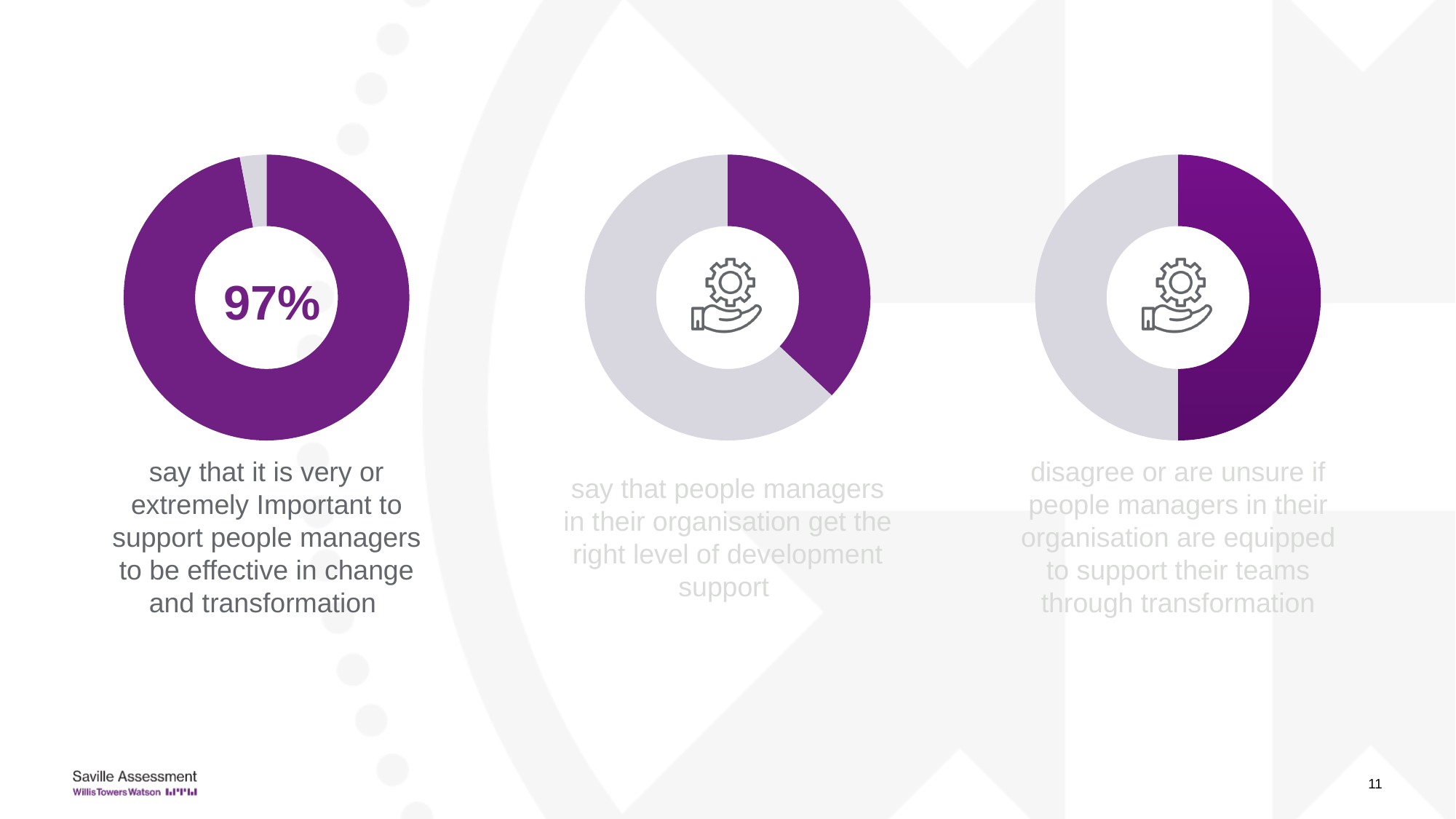
What kind of chart is the left-hand chart on the slide? donut chart How many donut charts are shown on the slide? 3 Which chart has the larger purple highlighted share: the middle chart or the right-hand chart? the right-hand chart Which chart has the larger purple highlighted share: the left-hand chart or the middle chart? the left-hand chart Which of the three donut charts has the largest purple highlighted share? the left-hand chart Which of the three donut charts has the smallest purple highlighted share? the middle chart What percentage is printed in the centre of the left-hand donut chart? 97% What colour is used for the highlighted segment in each donut chart? purple According to the caption under the left-hand donut chart, what do 97% of respondents say? that it is very or extremely important to support people managers to be effective in change and transformation In the left-hand donut chart, what share of the ring is not highlighted in purple, given the 97% label? 3%